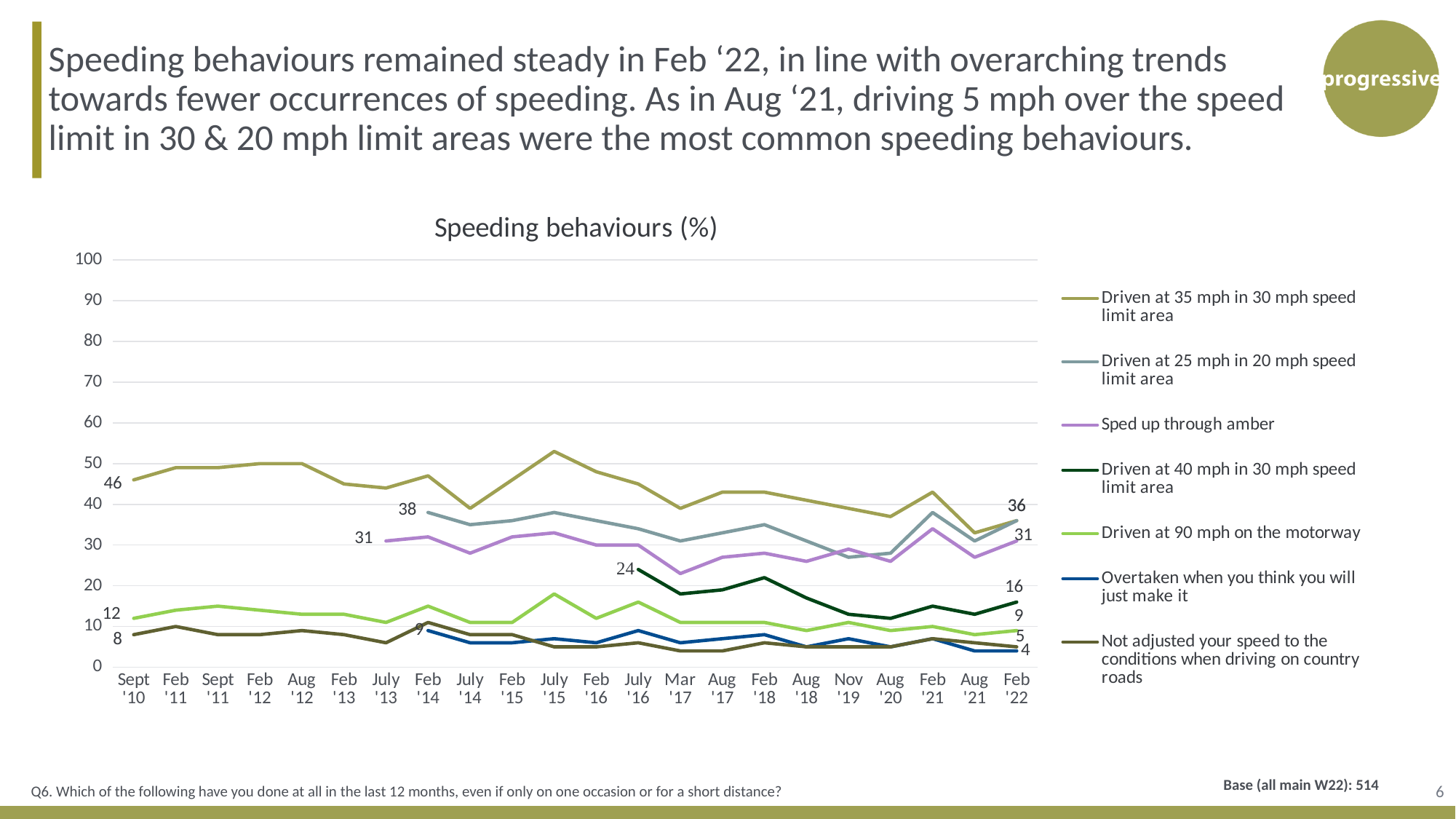
Which series has the highest value at Sept '10? Driven at 35 mph in 30 mph speed limit area By how much did 'Driven at 40 mph in 30 mph speed limit area' fall between July '16 and Feb '22? 8 What is the value for 'Driven at 40 mph in 30 mph speed limit area' at Feb '22? 16 Is the value for 'Driven at 35 mph in 30 mph speed limit area' at July '15 greater or less than 50? greater At Feb '22, which is larger: 'Driven at 40 mph in 30 mph speed limit area' or 'Driven at 90 mph on the motorway'? Driven at 40 mph in 30 mph speed limit area What type of chart is shown on the slide? Line chart What is the value for 'Driven at 40 mph in 30 mph speed limit area' at July '16? 24 What is the value for 'Driven at 35 mph in 30 mph speed limit area' at Sept '10? 46 How many series does the legend of the 'Speeding behaviours (%)' chart list? 7 What is the value for 'Driven at 25 mph in 20 mph speed limit area' at Feb '14? 38 How many time points are shown along the x axis of the chart? 22